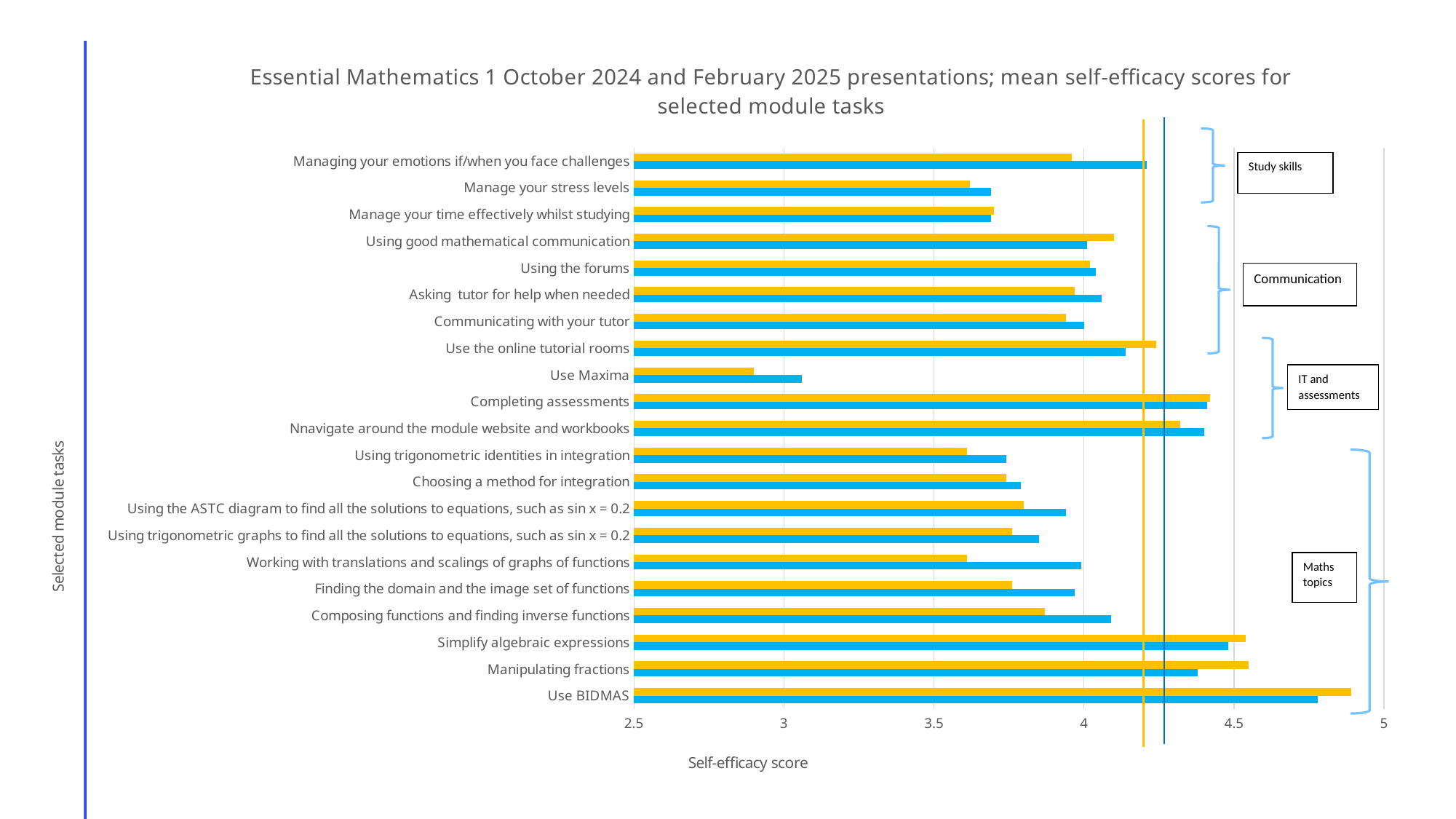
Which has the larger self-efficacy score, Use BIDMAS or Use Maxima? Use BIDMAS What is the title of the horizontal axis of the chart? Self-efficacy score What kind of chart is shown on the slide? bar chart Is the value for Using trigonometric identities in integration greater or less than 4? less Which has the larger self-efficacy score, Completing assessments or Manage your stress levels? Completing assessments How many module tasks are listed on the vertical axis of the chart? 21 Is the value for Manage your stress levels greater or less than 4? less What label is shown in the box next to the bracket grouping the bottom ten tasks? Maths topics Which module task has the lowest self-efficacy score? Use Maxima Is the value for Use BIDMAS greater or less than 4.5? greater Which module task has the highest self-efficacy score? Use BIDMAS